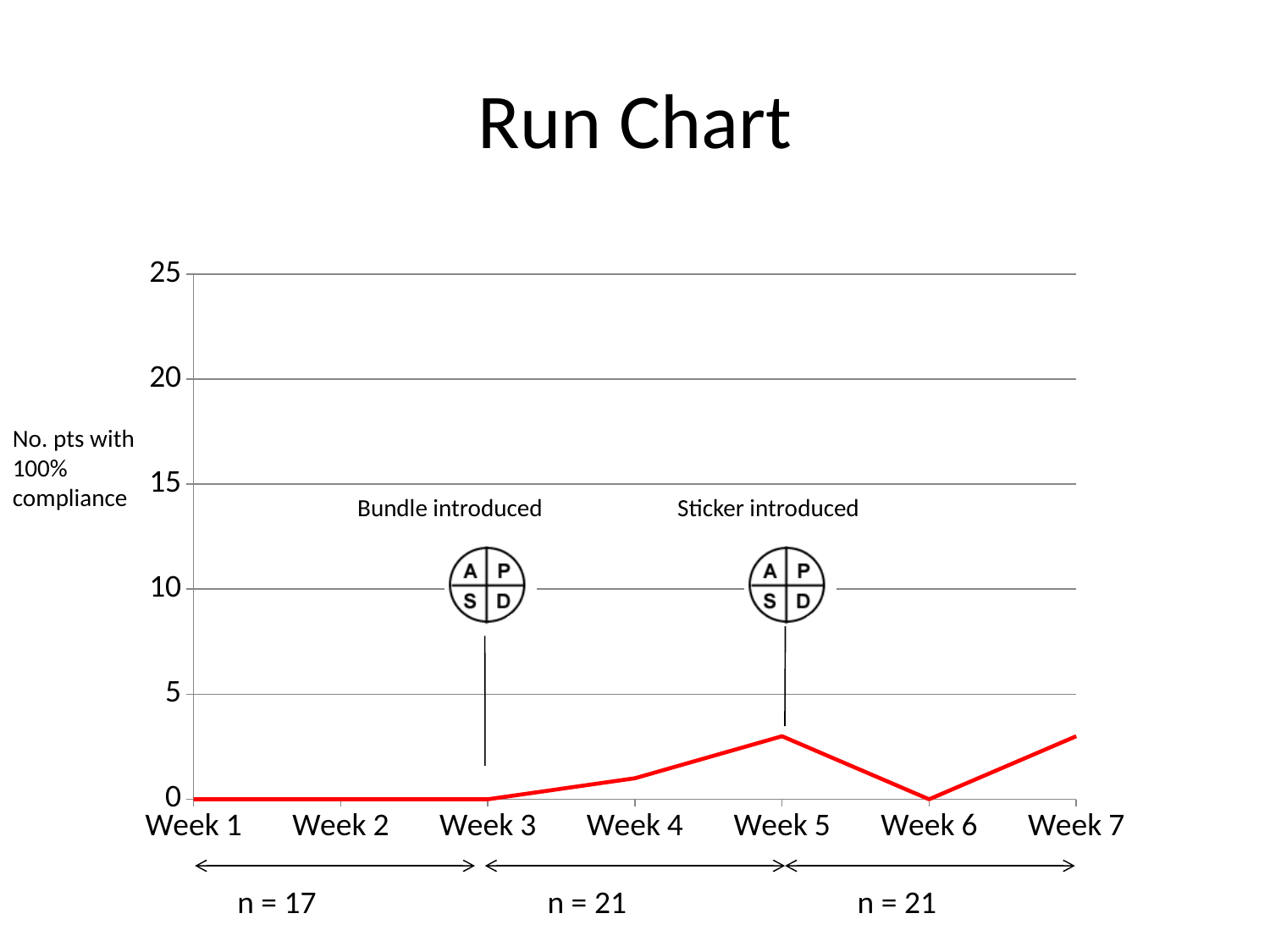
What is the title of the chart? Run Chart What kind of chart is shown on the slide? Line chart Which is larger, the value for Week 4 or the value for Week 6? Week 4 How many weeks are plotted on the x axis? 7 Is the value for Week 5 greater or less than 5? less Do the values rise or fall from Week 3 to Week 5? Rise Which is larger, the value for Week 4 or the value for Week 5? Week 5 What is the value for Week 1? 0 At which week was the bundle introduced, according to the annotation? Week 3 What is the value for Week 3? 0 Is the value for Week 7 greater or less than 5? less What is the value for Week 6? 0